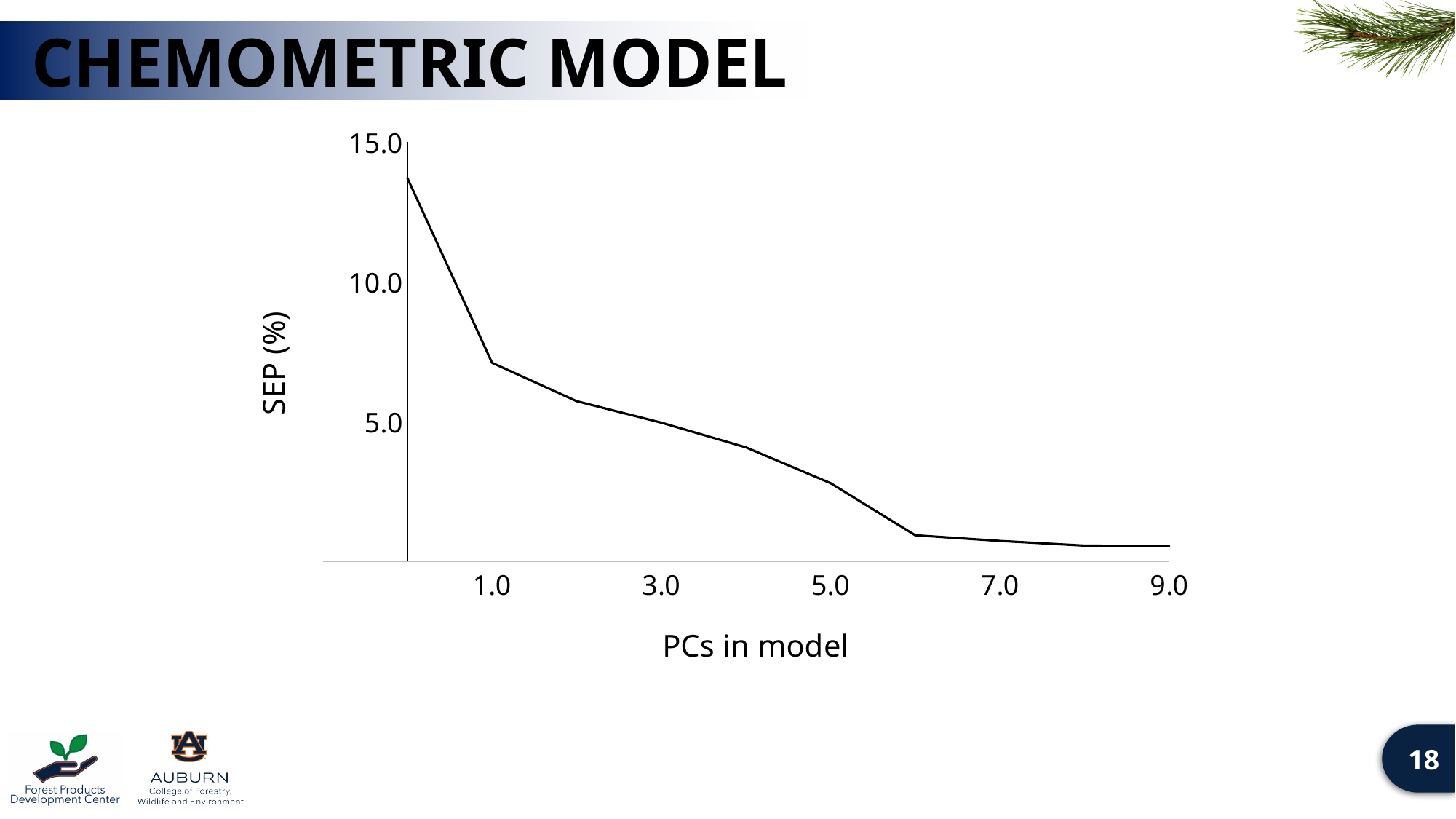
Is the SEP (%) value at 3.0 PCs in the model greater or less than 10.0? less What is the label of the y axis? SEP (%) Does SEP (%) rise or fall as the number of PCs in the model increases? fall Is the SEP (%) value at 1.0 PCs in the model greater or less than 5.0? greater What is the label of the x axis? PCs in model Is the SEP (%) value at 5.0 PCs in the model greater or less than 5.0? less What kind of chart is shown on the slide? line chart Which has the larger SEP (%): 1.0 PCs in the model or 5.0 PCs in the model? 1.0 PCs in model Which has the larger SEP (%): 3.0 PCs in the model or 9.0 PCs in the model? 3.0 PCs in model